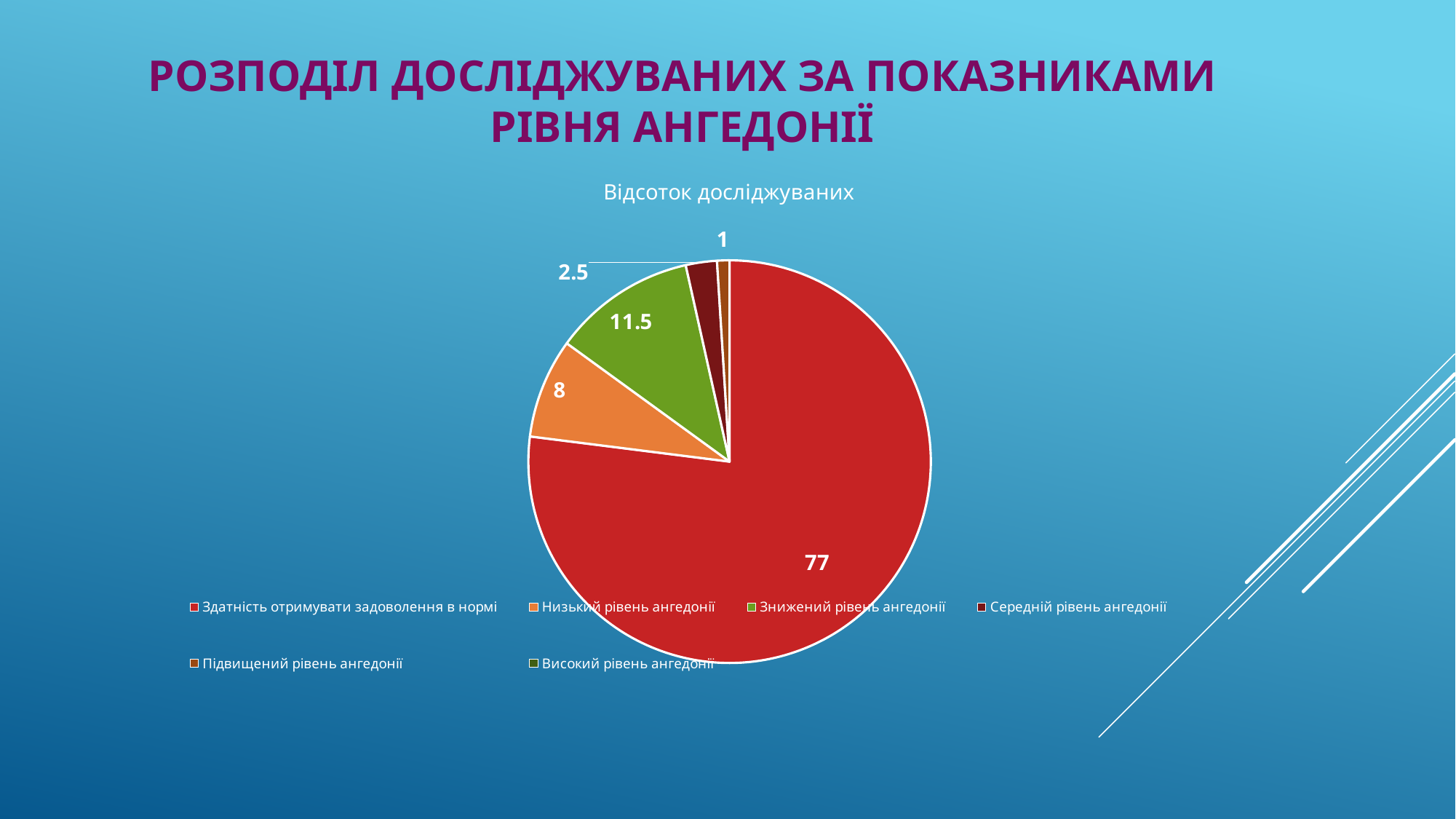
What kind of chart is shown on the slide? Pie chart What is the value for Низький рівень ангедонії? 8 What is the value for Середній рівень ангедонії? 2.5 What is the value for Здатність отримувати задоволення в нормі? 77 What is the difference between the values for Здатність отримувати задоволення в нормі and Низький рівень ангедонії? 69 Which is larger, the value for Знижений рівень ангедонії or the value for Низький рівень ангедонії? Знижений рівень ангедонії Which category has the smallest labelled slice of the pie? Підвищений рівень ангедонії How many categories does the legend list? 6 What is the value for Знижений рівень ангедонії? 11.5 What is the title of the chart? Відсоток досліджуваних What is the value for Підвищений рівень ангедонії? 1 Which category has the largest slice of the pie? Здатність отримувати задоволення в нормі